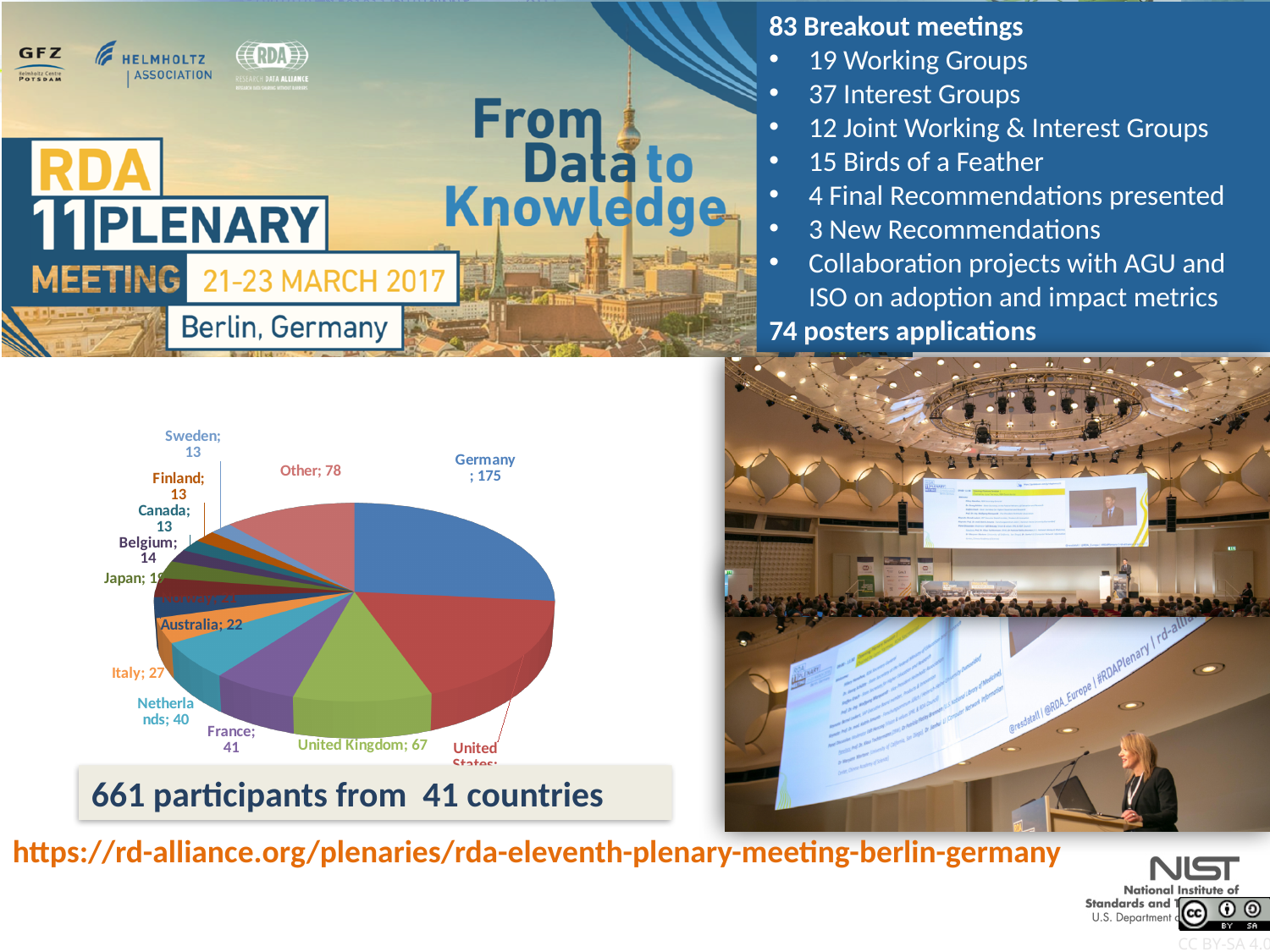
How many participants does the pie chart show for Germany? 175 What is the value shown for France in the pie chart? 41 According to the caption under the pie chart, how many participants attended in total? 661 Which country has the largest slice in the pie chart? Germany In the pie chart, which is larger: the value for Italy or the value for Australia? Italy What value is labelled for the Netherlands in the pie chart? 40 What kind of chart is used to show participants by country? Pie chart What value does the pie chart show for the 'Other' category? 78 How many participants are shown for Italy in the pie chart? 27 What value does the pie chart give for the United Kingdom? 67 What is the value for Australia in the pie chart? 22 What is the difference between the values for Germany and the United Kingdom in the pie chart? 108